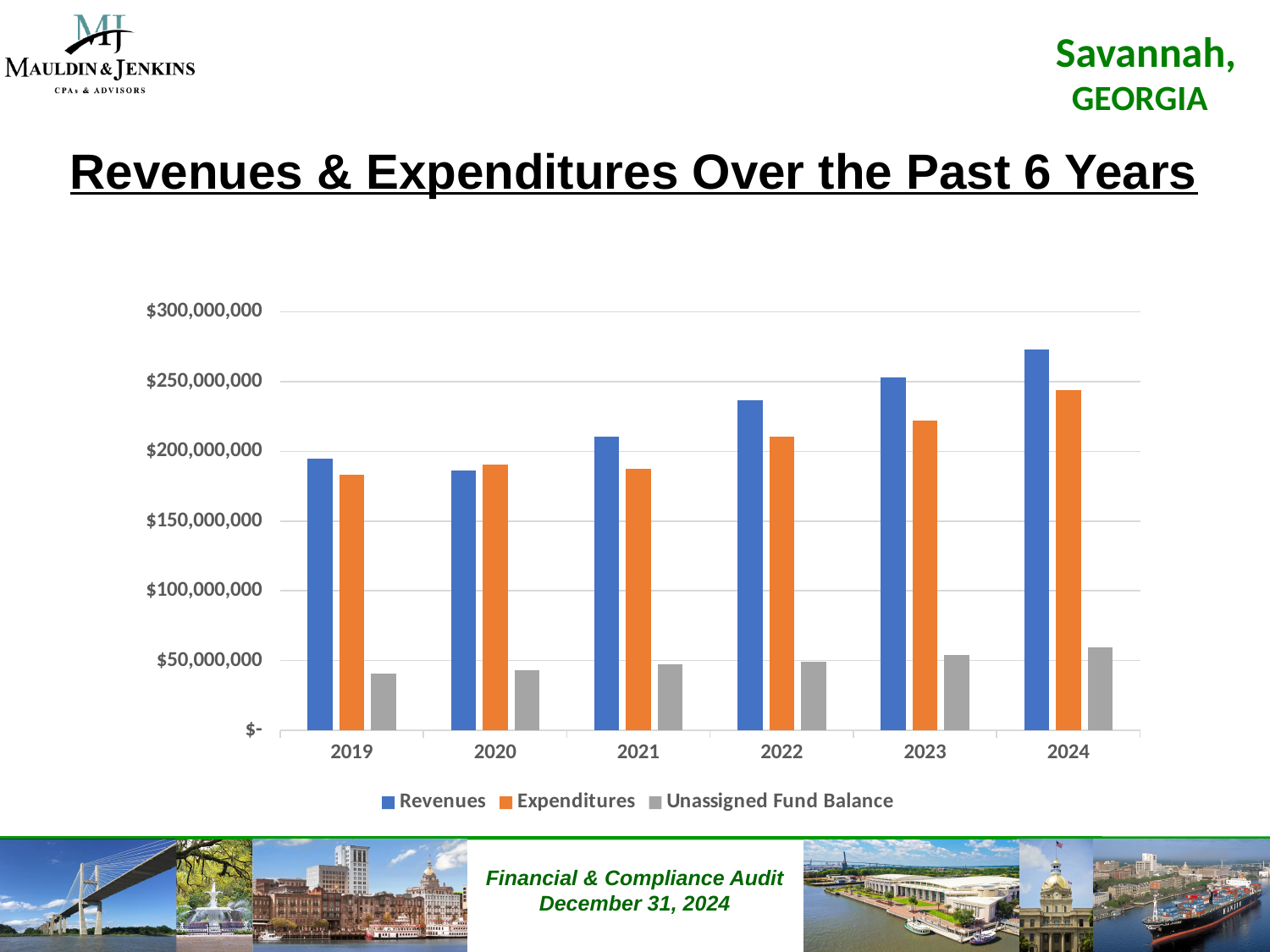
What is the title of the chart? Revenues & Expenditures Over the Past 6 Years How many years are shown on the x axis? 6 How many series does the legend list? 3 Is the value for Expenditures in 2019 greater or less than $200,000,000? less Does the Unassigned Fund Balance rise or fall from 2019 to 2024? rise Is the value for Unassigned Fund Balance in 2024 greater or less than $50,000,000? greater In which year is the Unassigned Fund Balance lowest? 2019 Is the value for Revenues in 2022 greater or less than $200,000,000? greater In which year are Revenues highest? 2024 In 2024, which is larger, Revenues or Expenditures? Revenues What kind of chart is shown on the slide? Bar chart